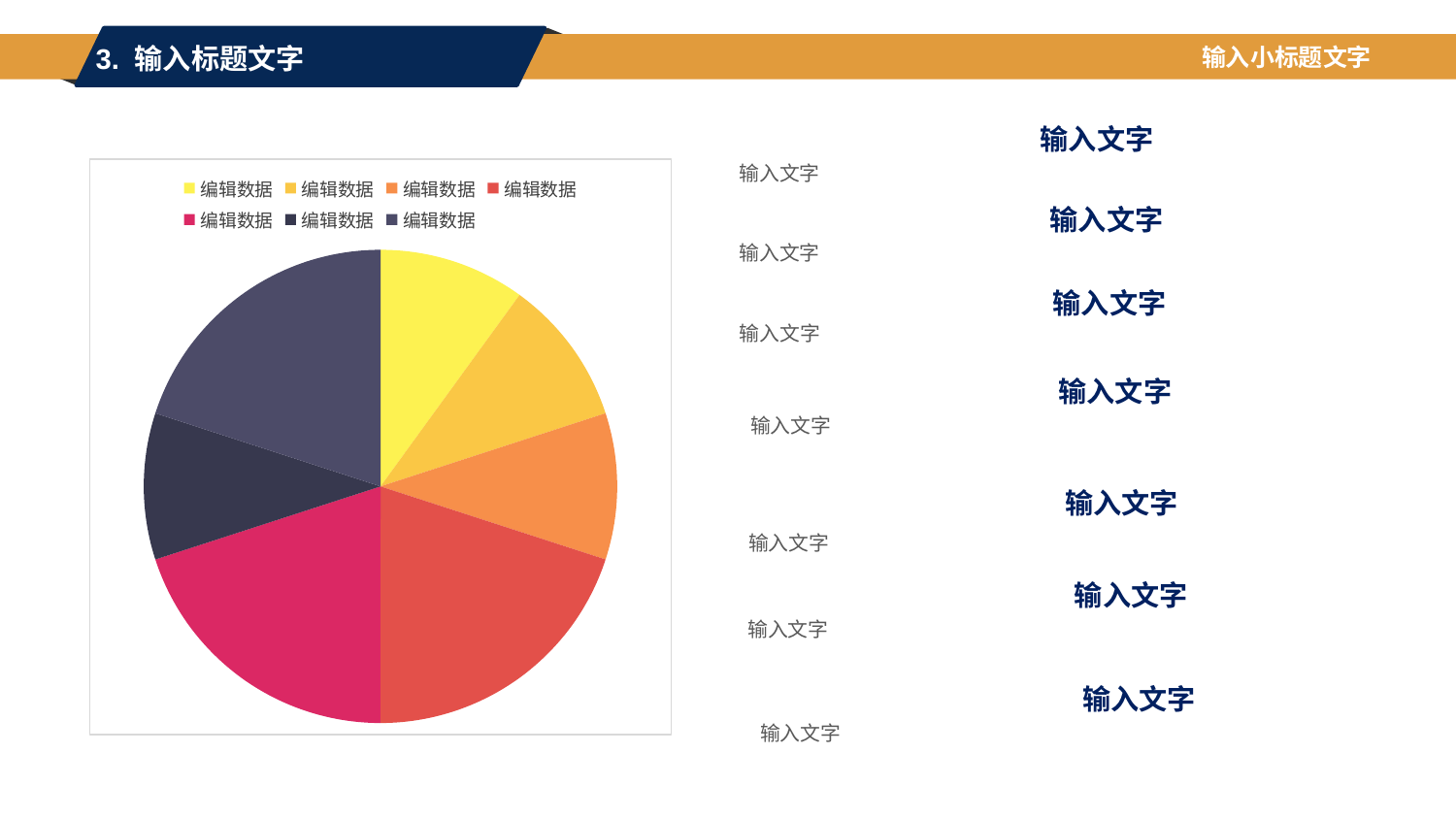
Where is the legend positioned relative to the pie chart? above the pie What text is used for every legend entry of the pie chart? 编辑数据 Which slice is larger, the dark purple-grey slice or the dark navy slice? the dark purple-grey slice Which slice is larger, the red slice or the bright yellow slice? the red slice How many slices does the pie chart have? 7 Which slice is larger, the pink slice or the orange slice? the pink slice What kind of chart is shown on the slide? pie chart How many entries does the legend of the pie chart list? 7